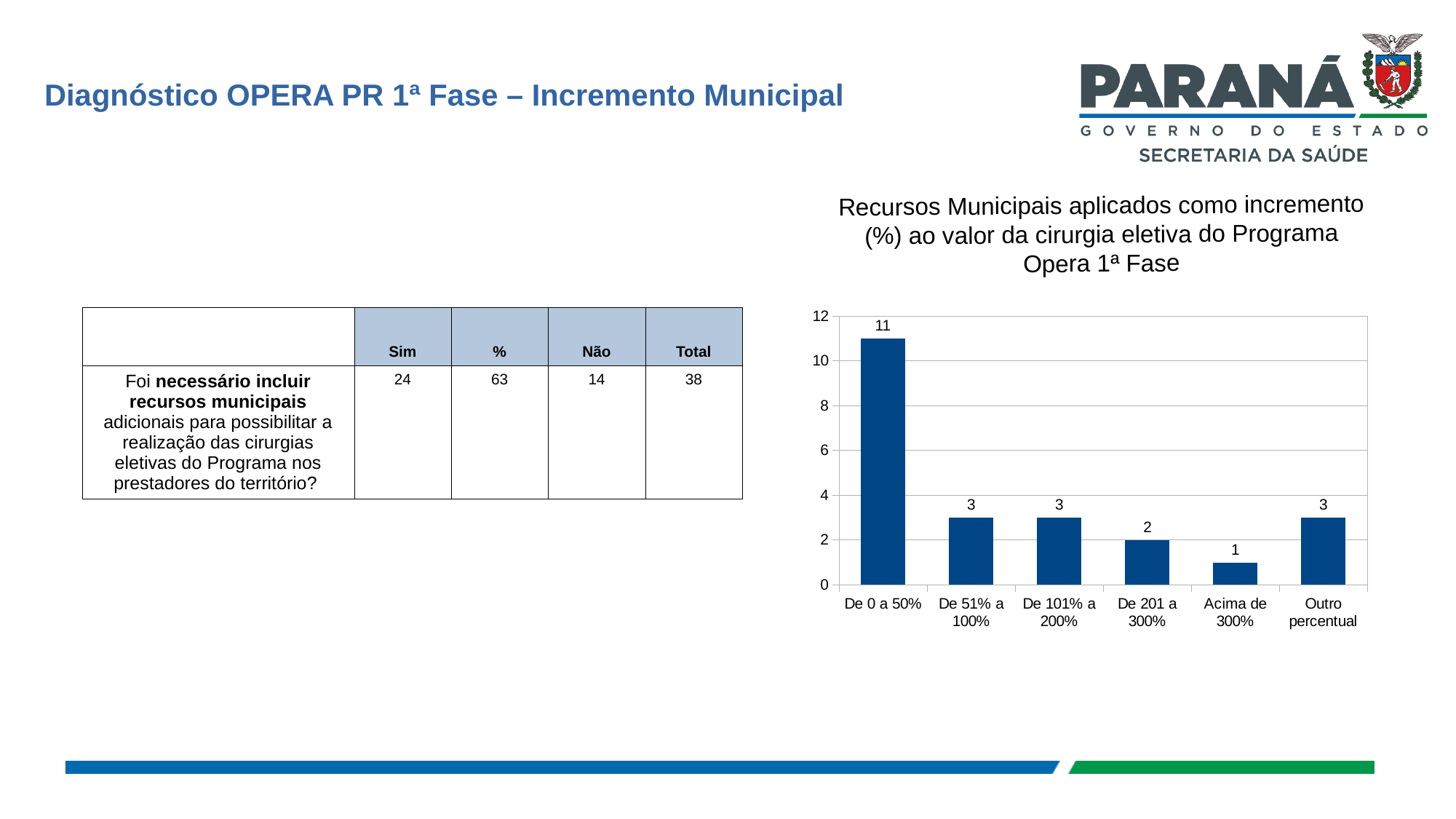
How many categories are shown on the x axis of the chart? 6 What is the value for the 'Acima de 300%' category? 1 What is the difference between the values for 'De 0 a 50%' and 'De 51% a 100%'? 8 Is the value for 'De 0 a 50%' greater or less than 10? greater Which category has the lowest value? Acima de 300% What is the value for the 'De 0 a 50%' category? 11 What is the value for the 'De 201 a 300%' category? 2 What kind of chart is shown on the slide? bar chart What is the maximum value shown on the chart's y axis? 12 Which is larger, the value for 'De 201 a 300%' or the value for 'Outro percentual'? Outro percentual Which category has the highest value? De 0 a 50% What is the title of the chart? Recursos Municipais aplicados como incremento (%) ao valor da cirurgia eletiva do Programa Opera 1ª Fase